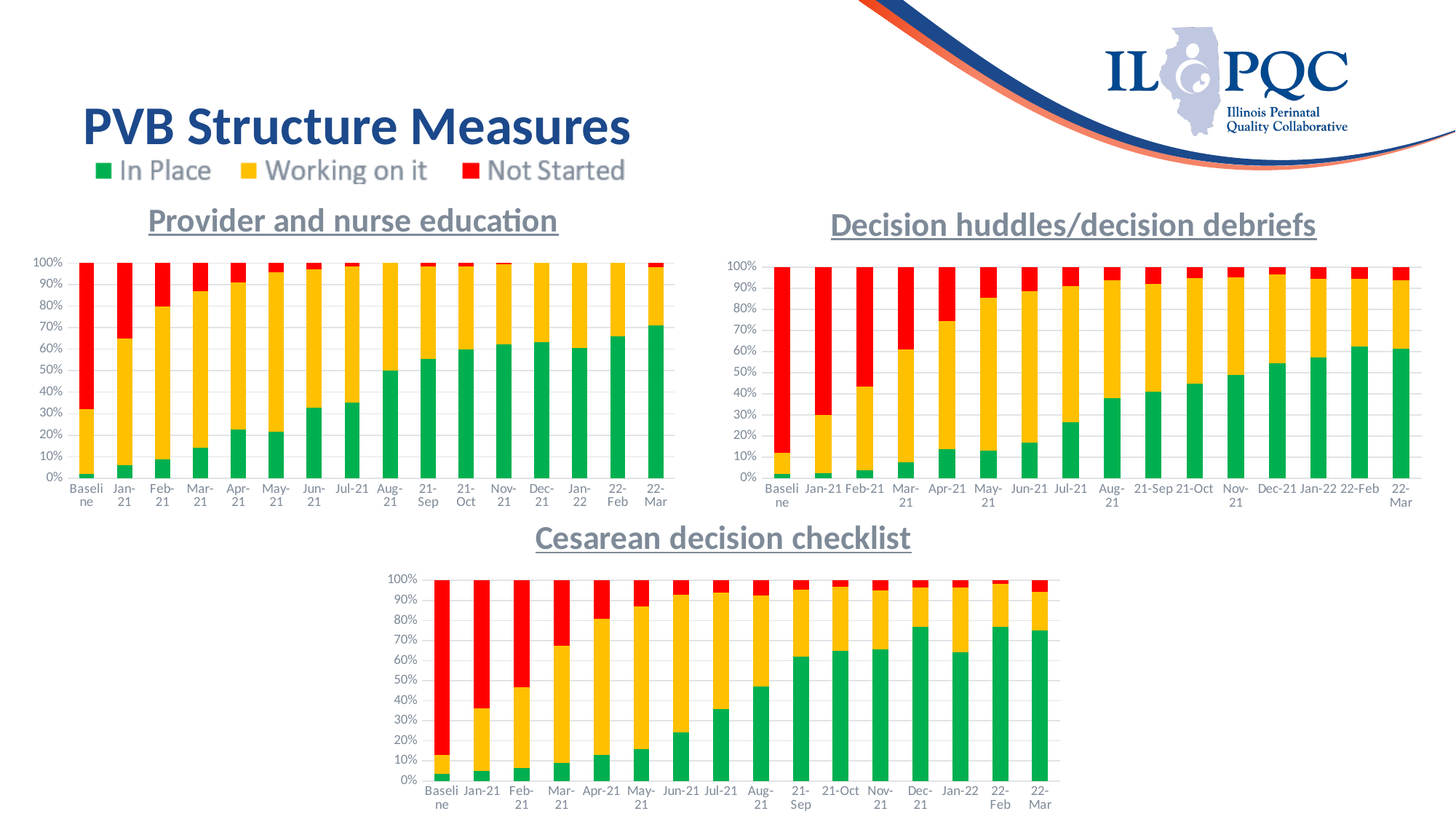
In the 'Cesarean decision checklist' chart, does the 'In Place' share generally rise or fall from Baseline to 22-Mar? rise In the 'Decision huddles/decision debriefs' chart, what does each stacked bar total? 100% How many series does the legend at the top of the slide list? 3 In the 'Decision huddles/decision debriefs' chart, is the 'Not Started' value for Baseline greater or less than 80%? greater In the 'Cesarean decision checklist' chart, is the 'In Place' value for Dec-21 greater or less than 70%? greater In the 'Decision huddles/decision debriefs' chart, which category has the lowest 'In Place' value? Baseline How many time-period categories are shown on the x axis of the 'Cesarean decision checklist' chart? 16 In the 'Provider and nurse education' chart, is the 'In Place' value for 22-Mar greater or less than 60%? greater What type of chart is the 'Provider and nurse education' chart? Stacked bar chart In the 'Provider and nurse education' chart, which category has the highest 'In Place' value? 22-Mar Which colour represents 'Not Started' in the legend? Red In the 'Provider and nurse education' chart, which is larger: the 'In Place' value for Aug-21 or for Apr-21? Aug-21